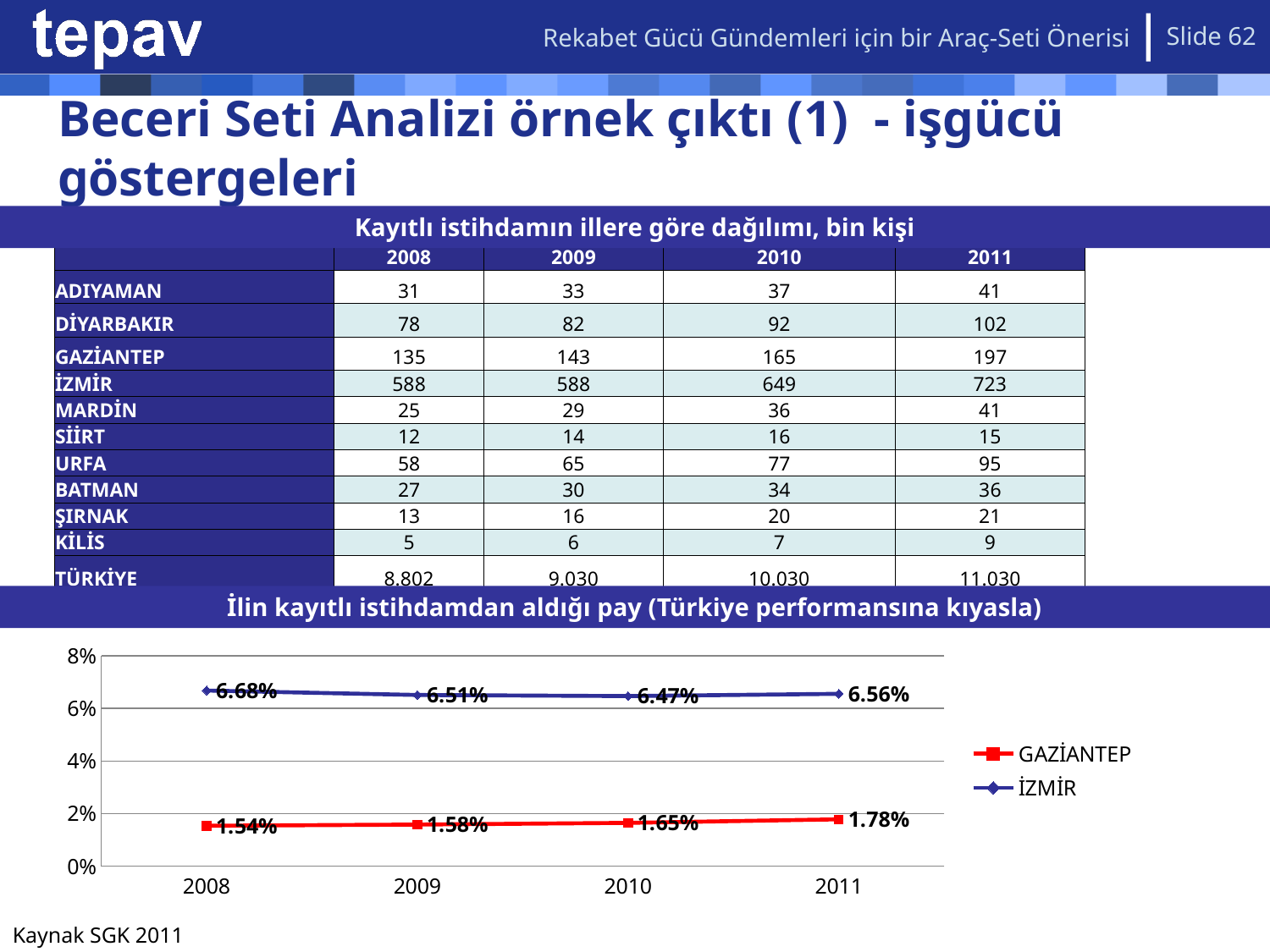
What is the value for İZMİR in 2010 in the line chart? 6.47% What is the value for İZMİR in 2008 in the line chart? 6.68% In which year is the GAZİANTEP series at its highest in the line chart? 2011 Which series has the larger value in 2009 in the line chart, GAZİANTEP or İZMİR? İZMİR What kind of chart is shown at the bottom of the slide? line chart Does the GAZİANTEP series rise or fall from 2008 to 2011 in the line chart? rise How many series does the legend of the line chart list? 2 What is the value for GAZİANTEP in 2011 in the line chart? 1.78% What is the difference between the İZMİR and GAZİANTEP values in 2011 in the line chart? 4.78% What is the value for GAZİANTEP in 2009 in the line chart? 1.58% Is the value for İZMİR in 2011 greater or less than 6%? greater In which year is the İZMİR series at its lowest in the line chart? 2010